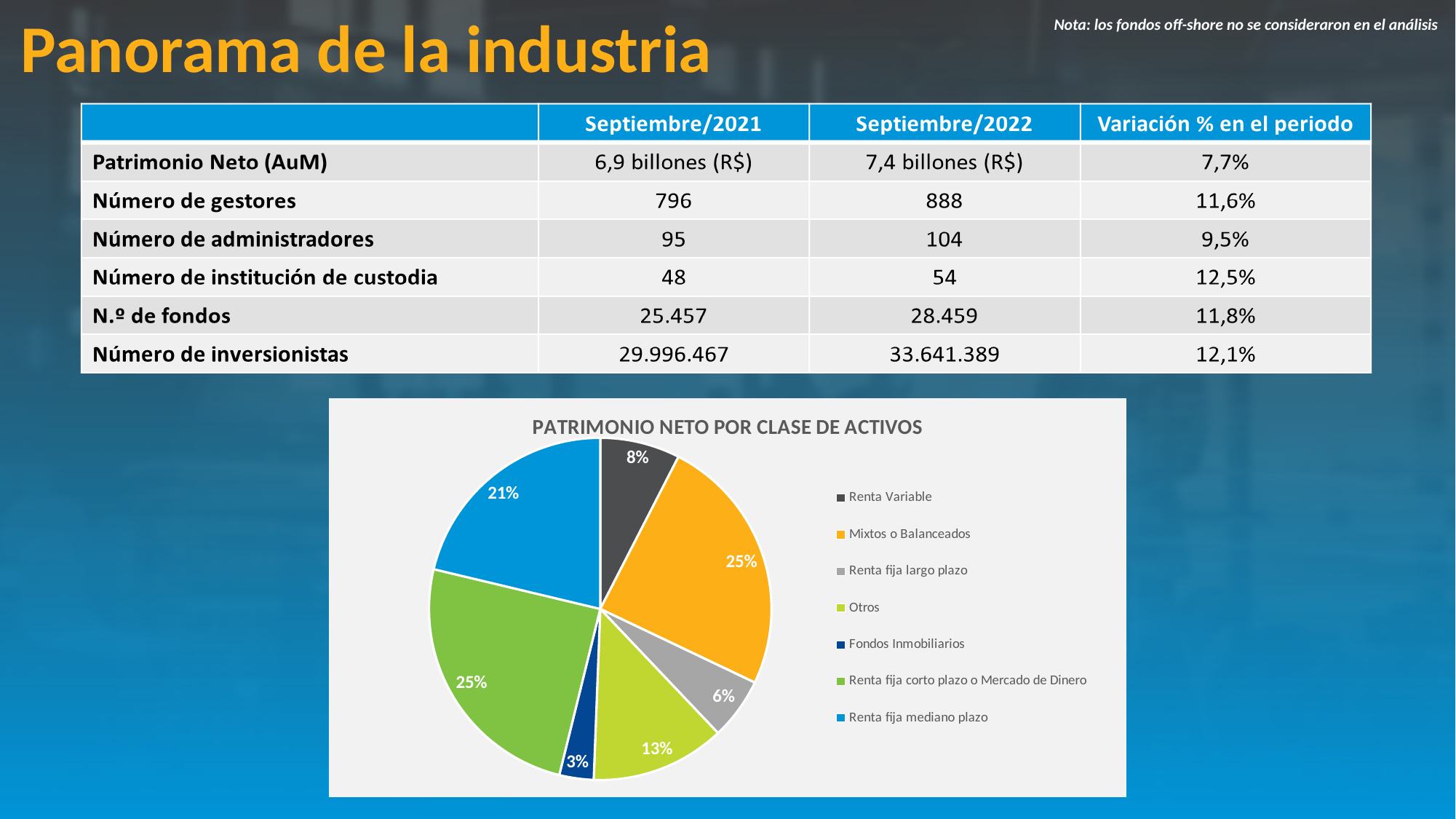
In the pie chart, what share does Renta fija mediano plazo have? 21% In the pie chart, what share does Mixtos o Balanceados have? 25% What kind of chart is shown under the title "PATRIMONIO NETO POR CLASE DE ACTIVOS"? Pie chart In the pie chart, which is larger: Otros or Renta fija largo plazo? Otros In the pie chart, what is the combined share of Fondos Inmobiliarios and Renta fija largo plazo? 9% In the pie chart, what share does Otros have? 13% What colour is the Renta fija corto plazo o Mercado de Dinero slice in the pie chart? Green In the pie chart, what share does Renta Variable have? 8% Which category has the smallest slice in the pie chart? Fondos Inmobiliarios In the pie chart, what is the difference between the shares of Renta fija mediano plazo and Renta Variable? 13 percentage points In the pie chart, what share does Renta fija largo plazo have? 6% How many categories does the pie chart's legend list? 7